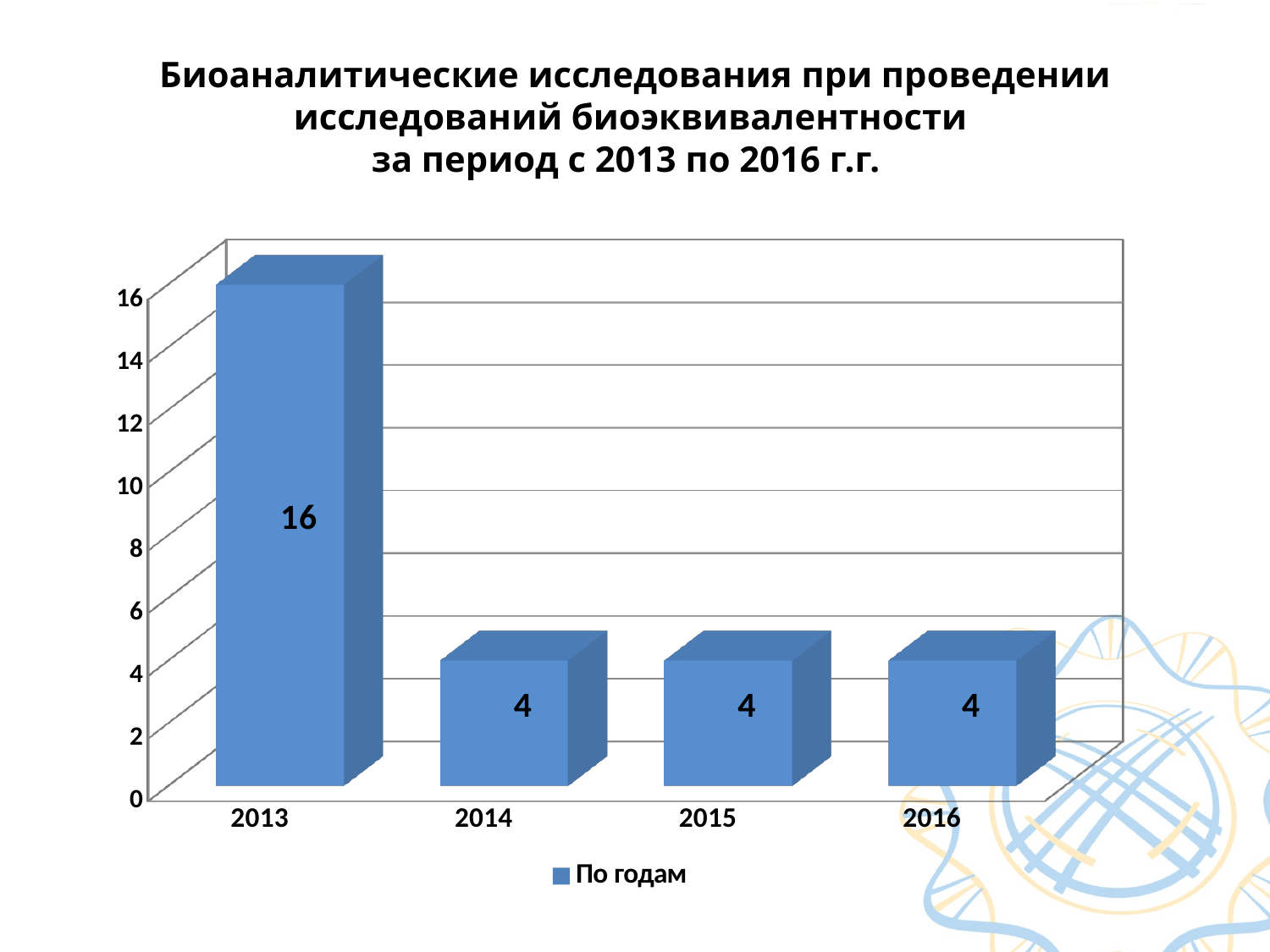
Which is larger, the value for 2013 or the value for 2014? 2013 How many series does the legend list? 1 What is the value for 2013? 16 What is the value for 2016? 4 What is the legend entry for the series? По годам What is the value for 2014? 4 How many years are shown on the x axis? 4 Is the value for 2015 greater or less than 8? less What kind of chart is shown on the slide? bar chart Is the value for 2013 greater or less than 10? greater What is the difference between the values for 2013 and 2015? 12 Which year has the highest value? 2013